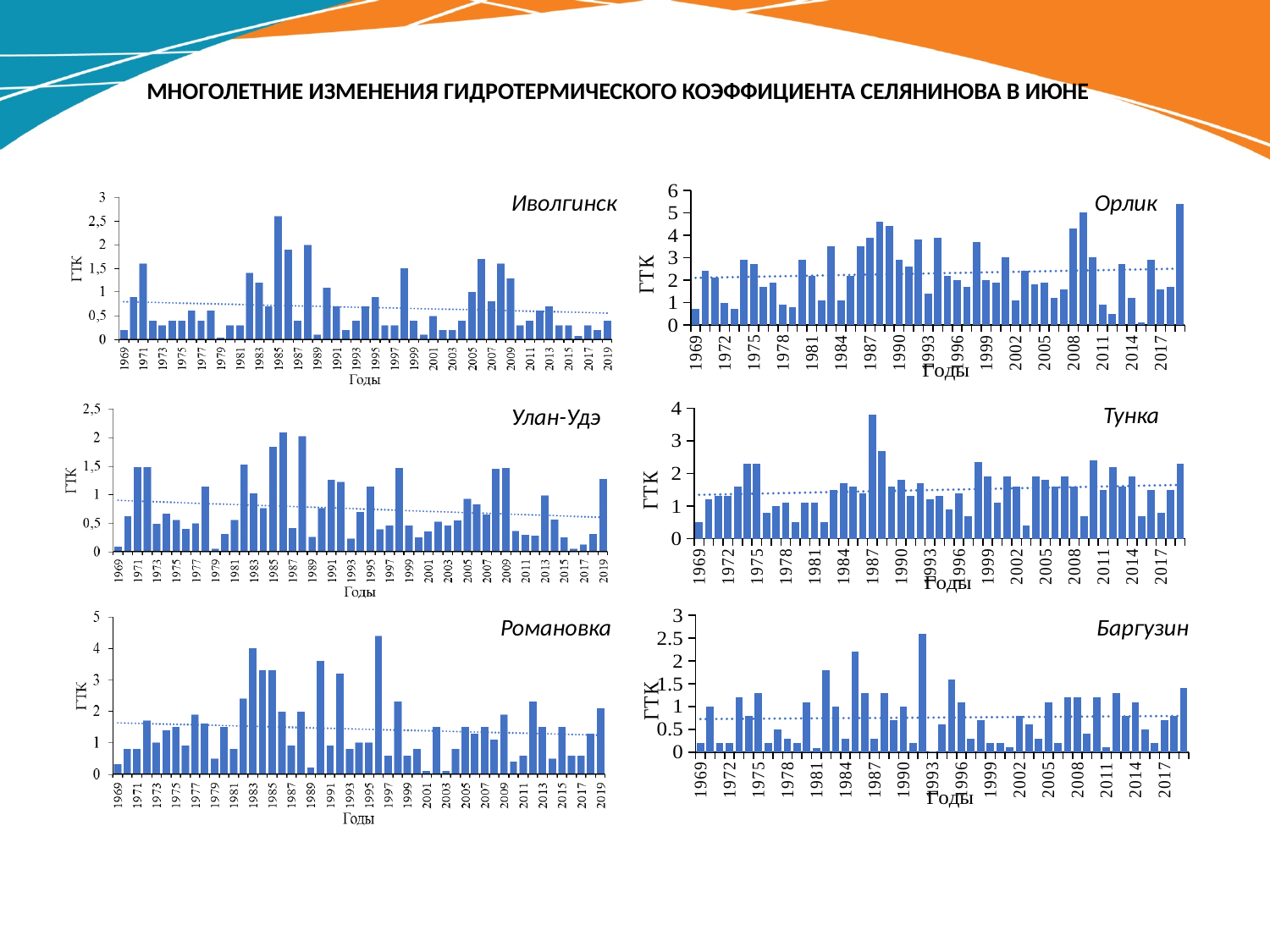
In the Романовка chart, which is larger, the value for 1983 or the value for 1969? 1983 In the Тунка chart, is the value for 1987 greater or less than 3? greater In the Баргузин chart, which year has the highest value? 1992 In the Иволгинск chart, which year has the highest value? 1985 What kind of chart is used for the Иволгинск panel? bar chart What is the label on the vertical axis of the Орлик chart? ГТК How many charts are shown on the slide? 6 In the Орлик chart, is the value for 2019 greater or less than 5? greater In the Иволгинск chart, does the dotted trend line rise or fall from left to right? fall In the Тунка chart, which year has the highest value? 1987 In the Улан-Удэ chart, is the value for 1986 greater or less than 1.5? greater